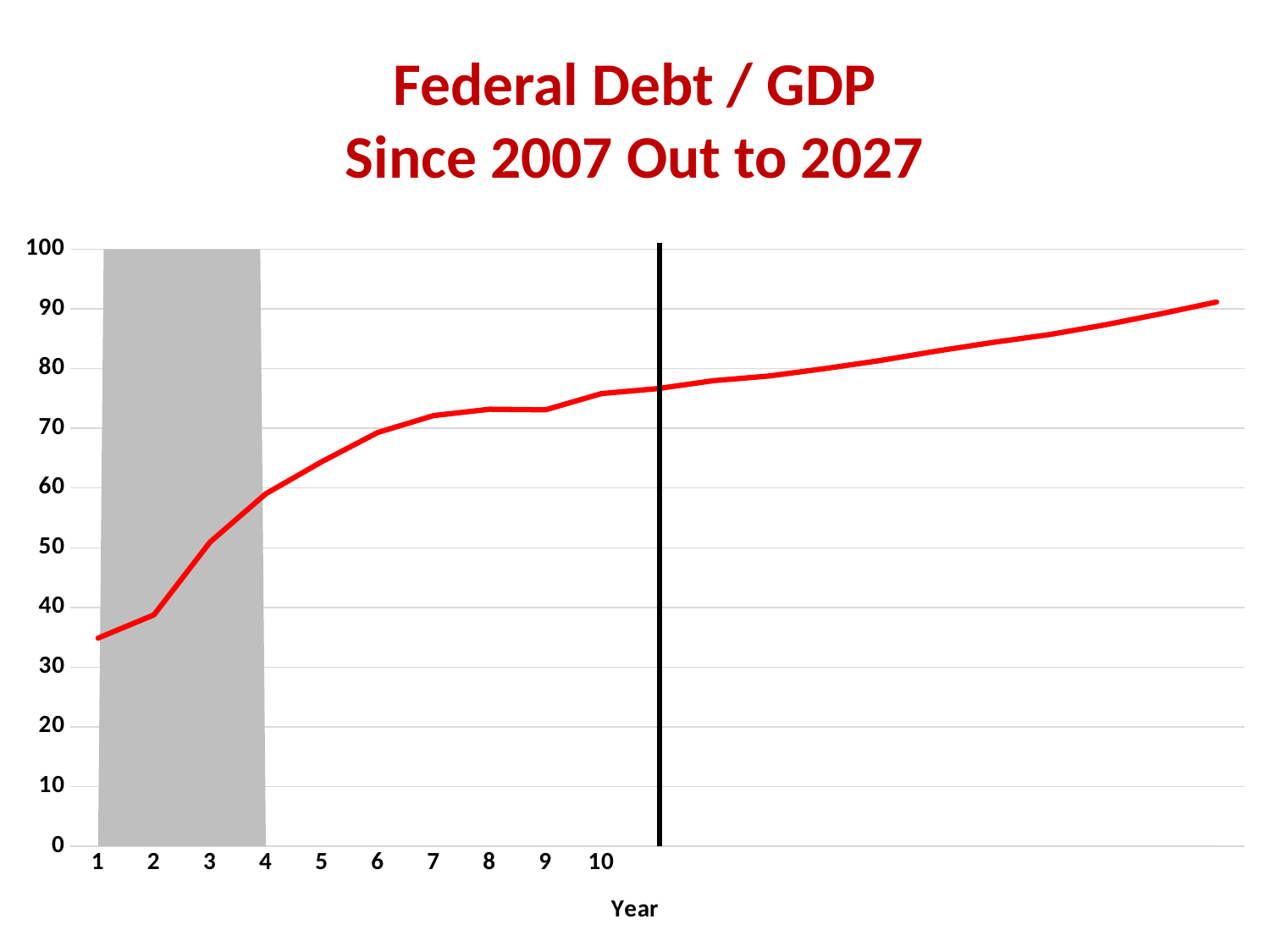
What kind of chart is shown on the slide? line chart Is the value for year 5 greater or less than 60? greater Is the value for year 1 greater or less than 40? less Is the value for year 10 greater or less than 80? less Which is larger, the value for year 3 or the value for year 5? year 5 What is the title of the chart? Federal Debt / GDP Since 2007 Out to 2027 Which labelled year has the lowest Federal Debt / GDP value? 1 Does the Federal Debt / GDP line rise or fall as the year increases? rise Which is larger, the value for year 10 or the value for year 1? year 10 What is the label on the x axis? Year